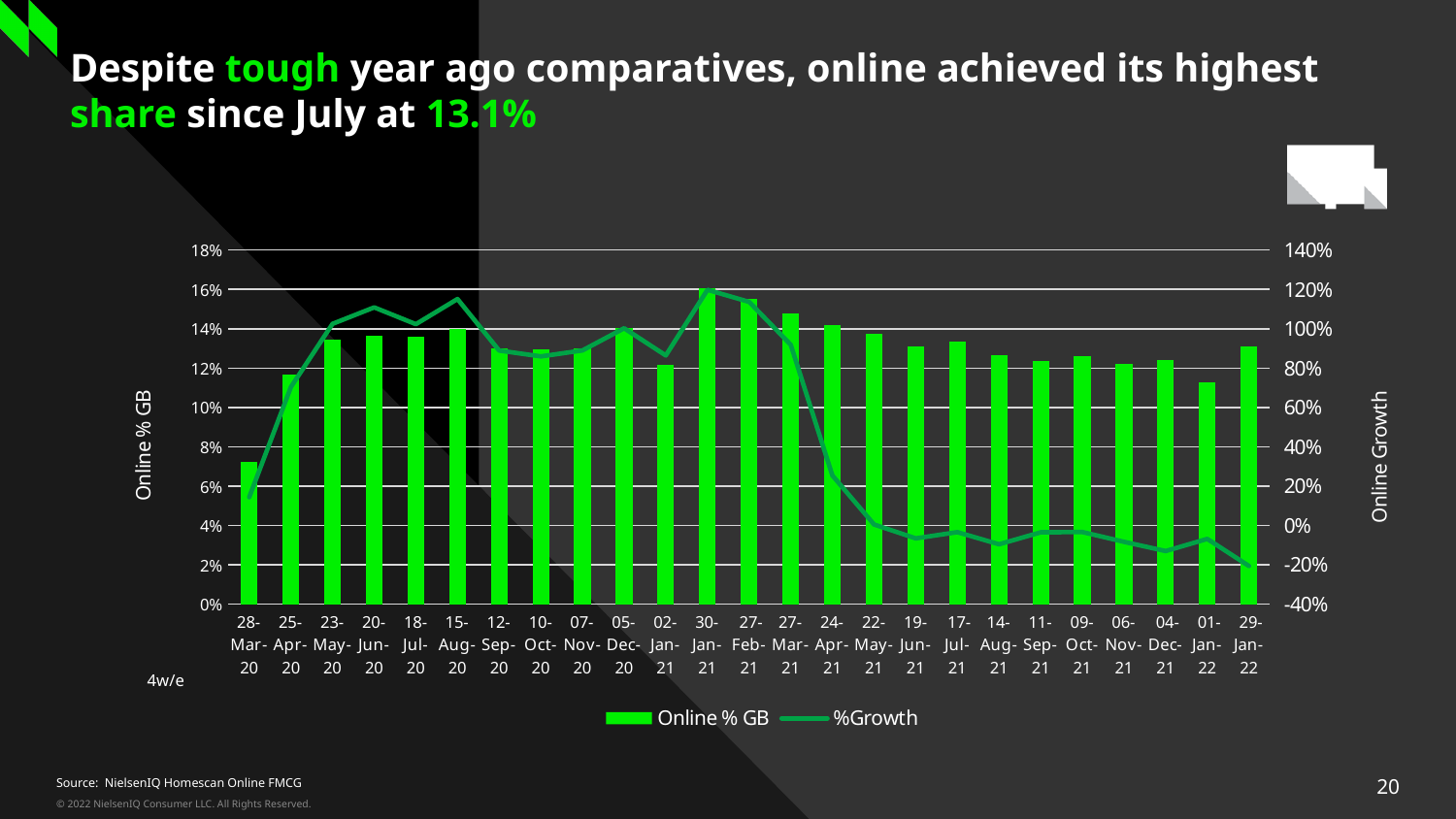
Which period has the lowest Online % GB bar? 28-Mar-20 Does the %Growth line rise or fall from 27-Mar-21 to 22-May-21? It falls How many 4-week periods are plotted along the x axis? 25 How many series does the legend list? 2 Is the Online % GB value for 01-Jan-22 greater or less than 12%? less Which period has the highest Online % GB bar? 30-Jan-21 What kind of chart is shown on the slide? A combination bar and line chart Which has the larger Online % GB bar, 28-Mar-20 or 25-Apr-20? 25-Apr-20 Is the %Growth value for 29-Jan-22 greater or less than 0%? less What online share does the slide title say was the highest since July? 13.1% Is the Online % GB value for 28-Mar-20 greater or less than 8%? less